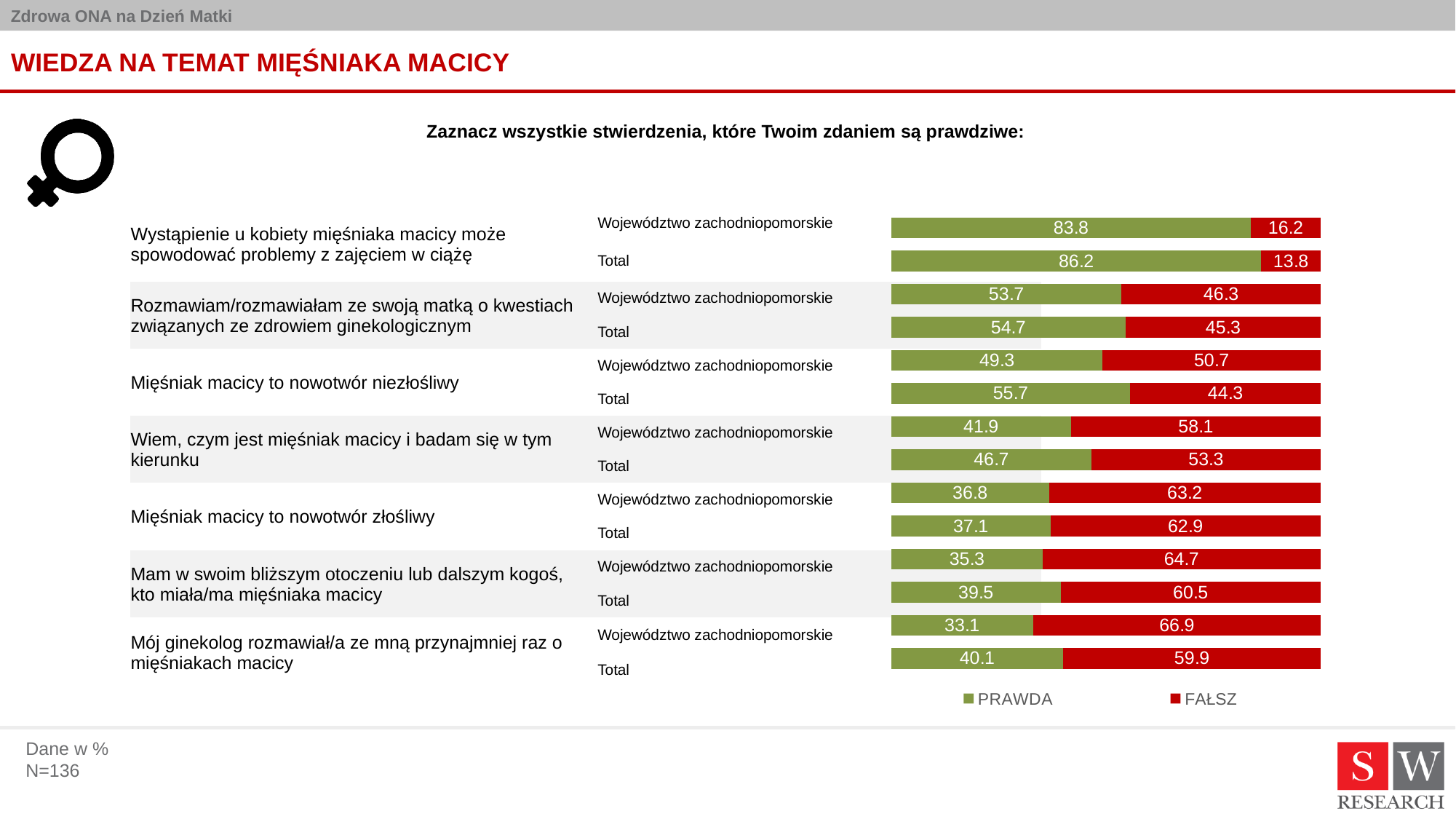
How many series does the legend list? 2 What is the difference between the Total and Województwo zachodniopomorskie PRAWDA values for the statement "Mięśniak macicy to nowotwór niezłośliwy"? 6.4 What is the FAŁSZ value for Województwo zachodniopomorskie for the statement "Mój ginekolog rozmawiał/a ze mną przynajmniej raz o mięśniakach macicy"? 66.9 Which statement has the lowest PRAWDA value for Województwo zachodniopomorskie? Mój ginekolog rozmawiał/a ze mną przynajmniej raz o mięśniakach macicy Which statement has the highest PRAWDA value for Total? Wystąpienie u kobiety mięśniaka macicy może spowodować problemy z zajęciem w ciążę What kind of chart is shown on the slide? Stacked bar chart For the statement "Wiem, czym jest mięśniak macicy i badam się w tym kierunku", which is larger: the PRAWDA value for Total or for Województwo zachodniopomorskie? Total What is the total of the stacked bar for Total for the statement "Mięśniak macicy to nowotwór złośliwy"? 100 What is the PRAWDA value for Województwo zachodniopomorskie for the statement "Mięśniak macicy to nowotwór niezłośliwy"? 49.3 What is the PRAWDA value for Total for the statement "Wystąpienie u kobiety mięśniaka macicy może spowodować problemy z zajęciem w ciążę"? 86.2 Which colour represents FAŁSZ in the chart? Red How many statements are shown in the chart? 7